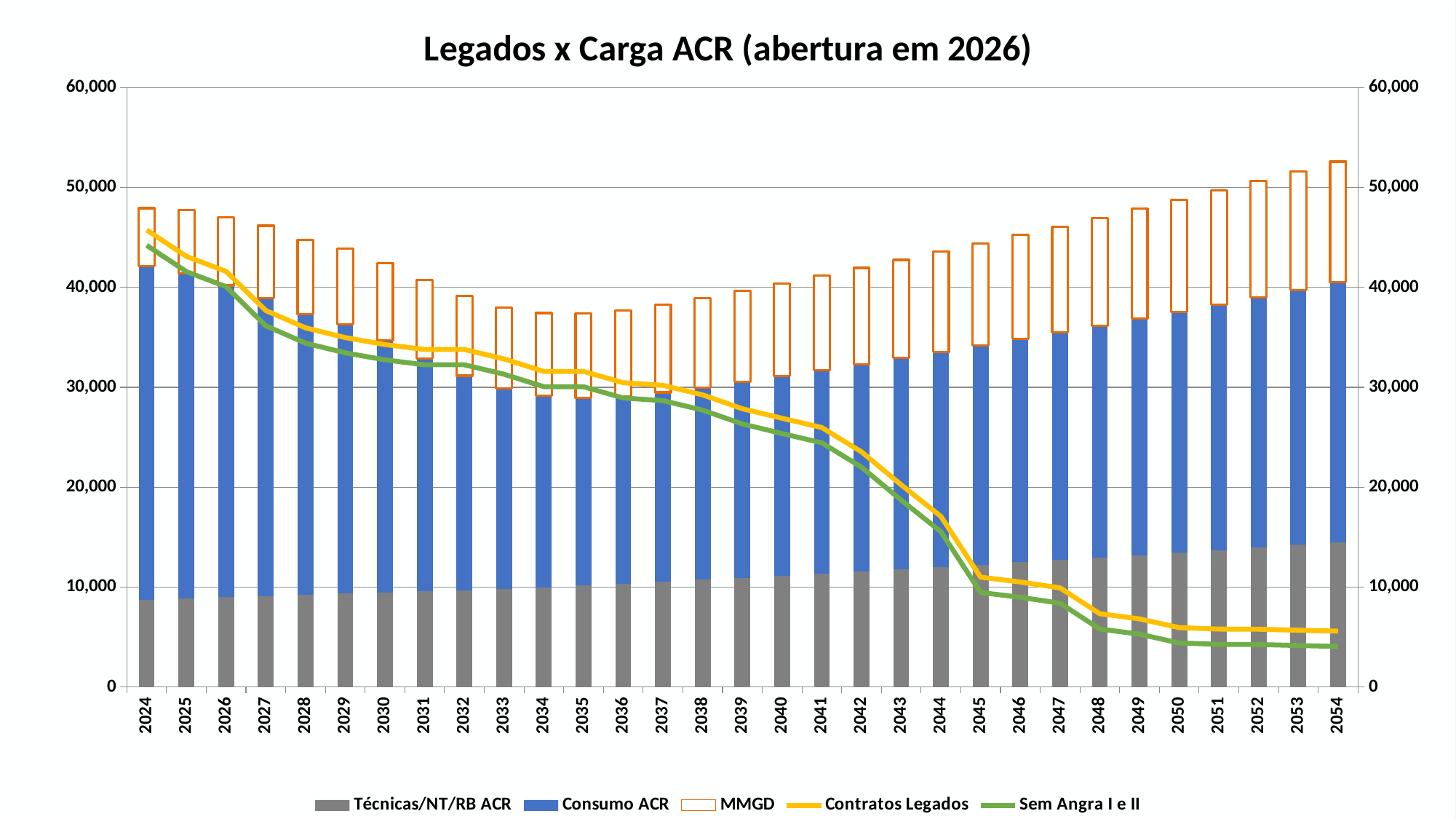
In 2040, which line is higher: Contratos Legados or Sem Angra I e II? Contratos Legados Is the value of Contratos Legados in 2054 greater or less than 10,000? less Which series is drawn as a yellow line? Contratos Legados Which year has the tallest stacked bar? 2054 Does the Contratos Legados line rise or fall from 2024 to 2054? fall Is the value of Sem Angra I e II in 2050 greater or less than 10,000? less Is the value of Contratos Legados in 2024 greater or less than 40,000? greater What is the title of the chart? Legados x Carga ACR (abertura em 2026) How many years are shown on the x axis? 31 How many series does the legend list? 5 What kind of chart is shown on the slide? Combination bar and line chart (stacked bars with lines)